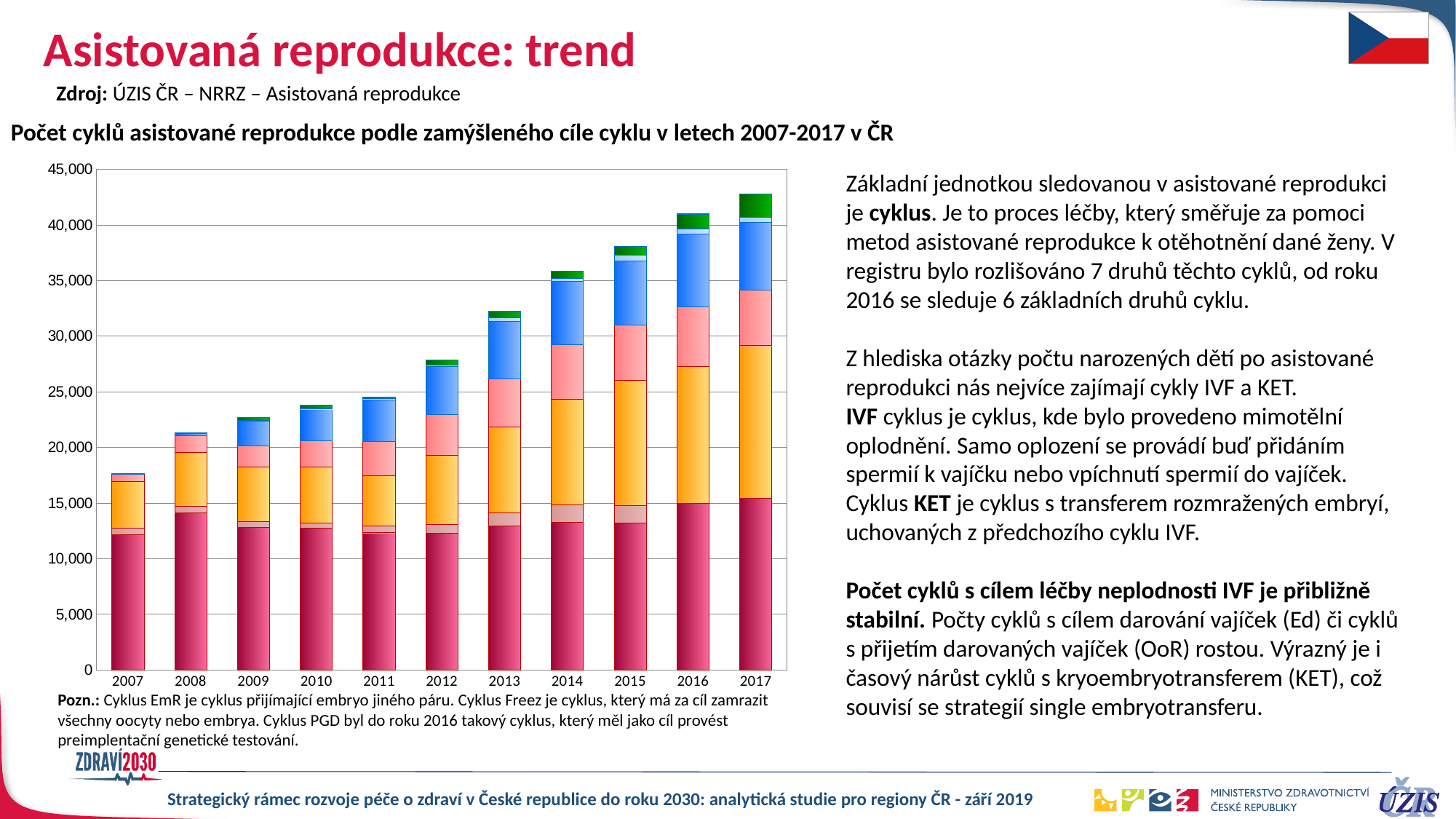
Is the total bar height for 2017 greater or less than 40,000? greater Do the total bar heights rise or fall from 2007 to 2017? rise Is the total bar height for 2010 greater or less than 25,000? less How many years are shown on the x axis of the chart? 11 Which year has the lowest total number of cycles? 2007 Which year has the highest total number of cycles? 2017 Is the total bar height for 2007 greater or less than 20,000? less What kind of chart is shown on the slide? stacked bar chart Which year has a taller total bar, 2012 or 2016? 2016 What is the title of the chart? Počet cyklů asistované reprodukce podle zamýšleného cíle cyklu v letech 2007-2017 v ČR